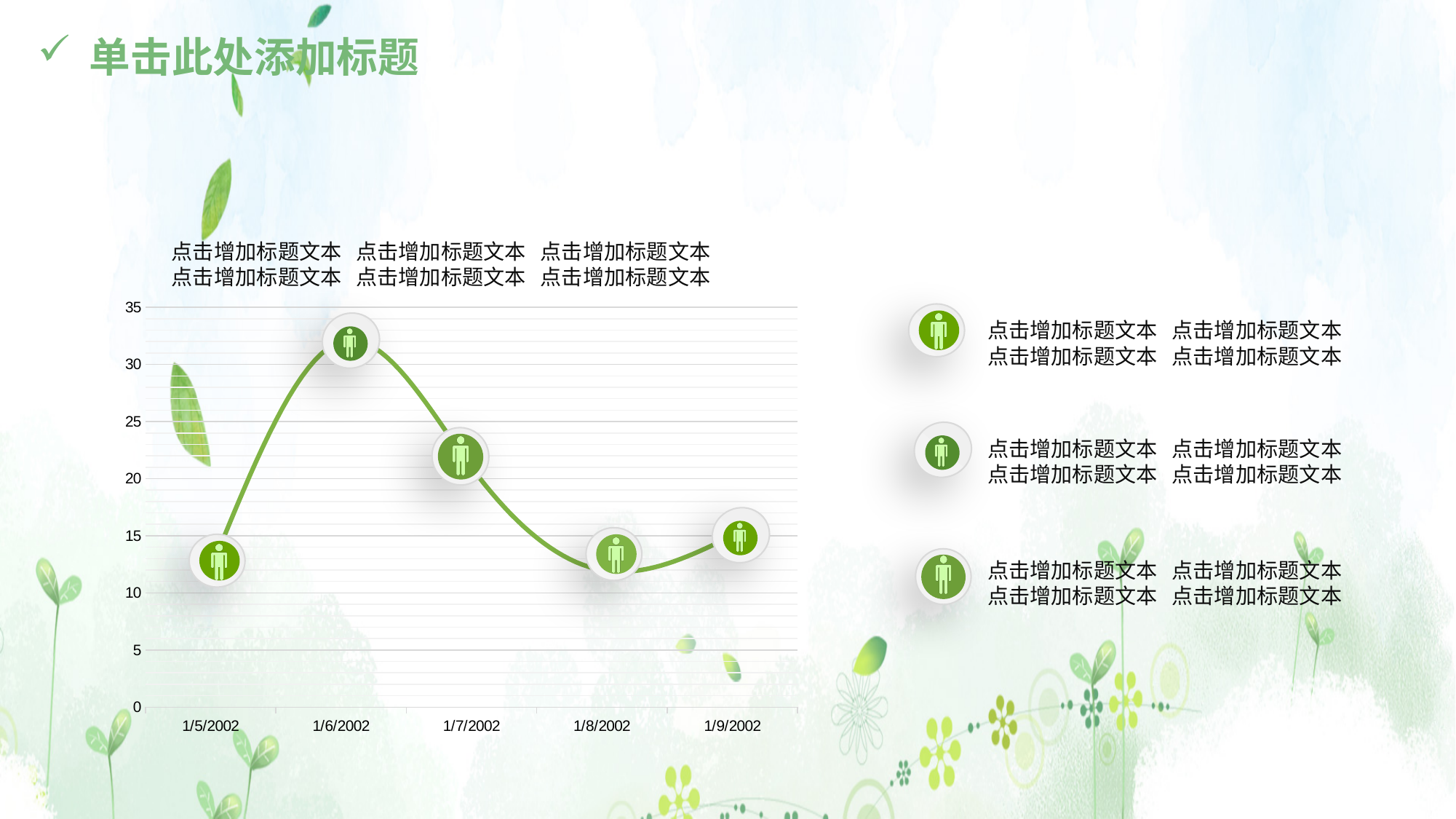
Is the value for 1/9/2002 greater or less than 20? less Which is larger, the value for 1/7/2002 or the value for 1/9/2002? 1/7/2002 What is the highest value shown on the vertical axis of the chart? 35 Is the value for 1/5/2002 greater or less than 10? greater Is the value for 1/6/2002 greater or less than 30? greater Does the line rise or fall from 1/6/2002 to 1/8/2002? fall How many data points are plotted on the line chart? 5 Which date has the highest value on the line chart? 1/6/2002 What kind of chart is shown on the slide? line chart Which is larger, the value for 1/6/2002 or the value for 1/7/2002? 1/6/2002